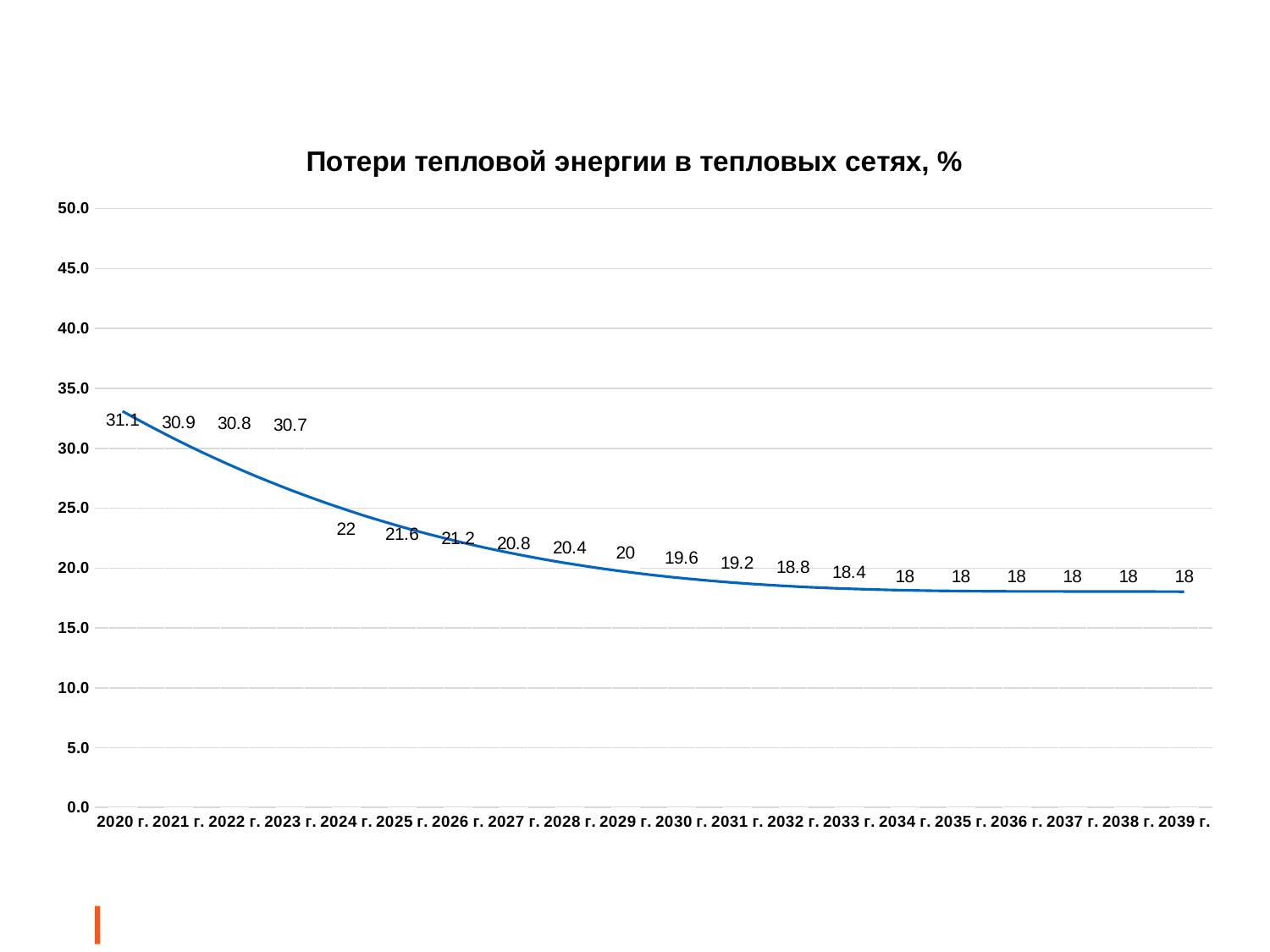
Which is larger, the value for 2022 г. or the value for 2028 г.? 2022 г. What is the value for 2039 г.? 18 How many years are shown on the x axis? 20 Do the values rise or fall from 2020 г. to 2039 г.? fall What is the value for 2024 г.? 22 Is the value for 2021 г. greater or less than 25.0? greater What is the value for 2030 г.? 19.6 What kind of chart is this? line chart Which year has the highest value? 2020 г. What is the value for 2020 г.? 31.1 What is the difference between the values for 2020 г. and 2039 г.? 13.1 What is the difference between the values for 2023 г. and 2024 г.? 8.7